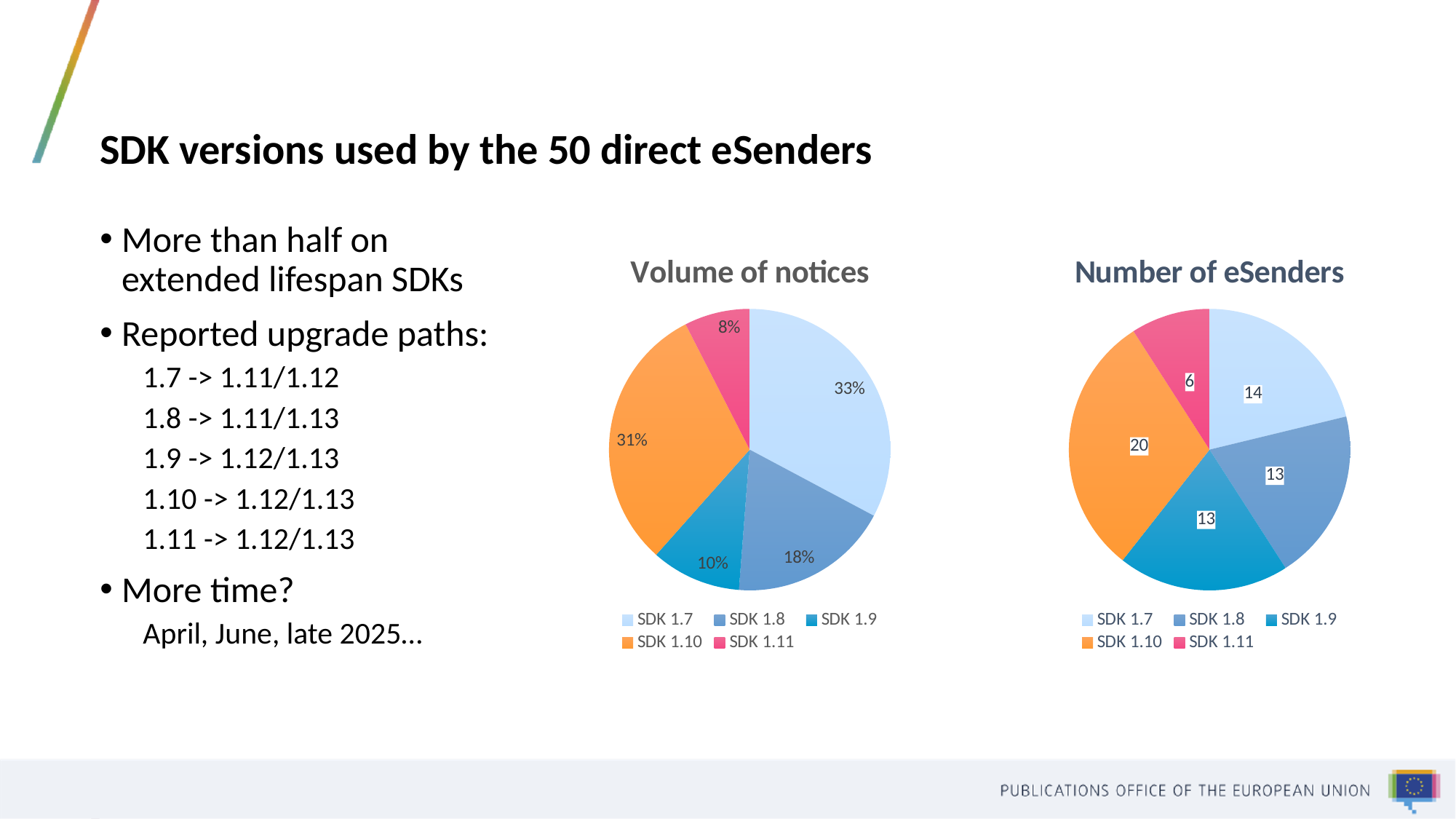
In the 'Volume of notices' chart, what is the difference in percentage points between SDK 1.8 and SDK 1.9? 8 In the 'Number of eSenders' chart, how many eSenders use SDK 1.11? 6 In the 'Number of eSenders' chart, which SDK version is used by the most eSenders? SDK 1.10 In the 'Volume of notices' chart, which SDK version has the largest share? SDK 1.7 In the 'Volume of notices' chart, which SDK version has the smallest share? SDK 1.11 In the 'Number of eSenders' chart, which is larger: the number of eSenders on SDK 1.7 or on SDK 1.11? SDK 1.7 In the 'Number of eSenders' chart, how many eSenders use SDK 1.10? 20 How many SDK versions does the legend of the 'Volume of notices' chart list? 5 In the 'Number of eSenders' chart, what is the difference between the number of eSenders on SDK 1.10 and on SDK 1.7? 6 In the 'Volume of notices' chart, what share of notices is attributed to SDK 1.7? 33% What type of chart is the 'Number of eSenders' chart? Pie chart In the 'Volume of notices' chart, what share of notices is attributed to SDK 1.10? 31%